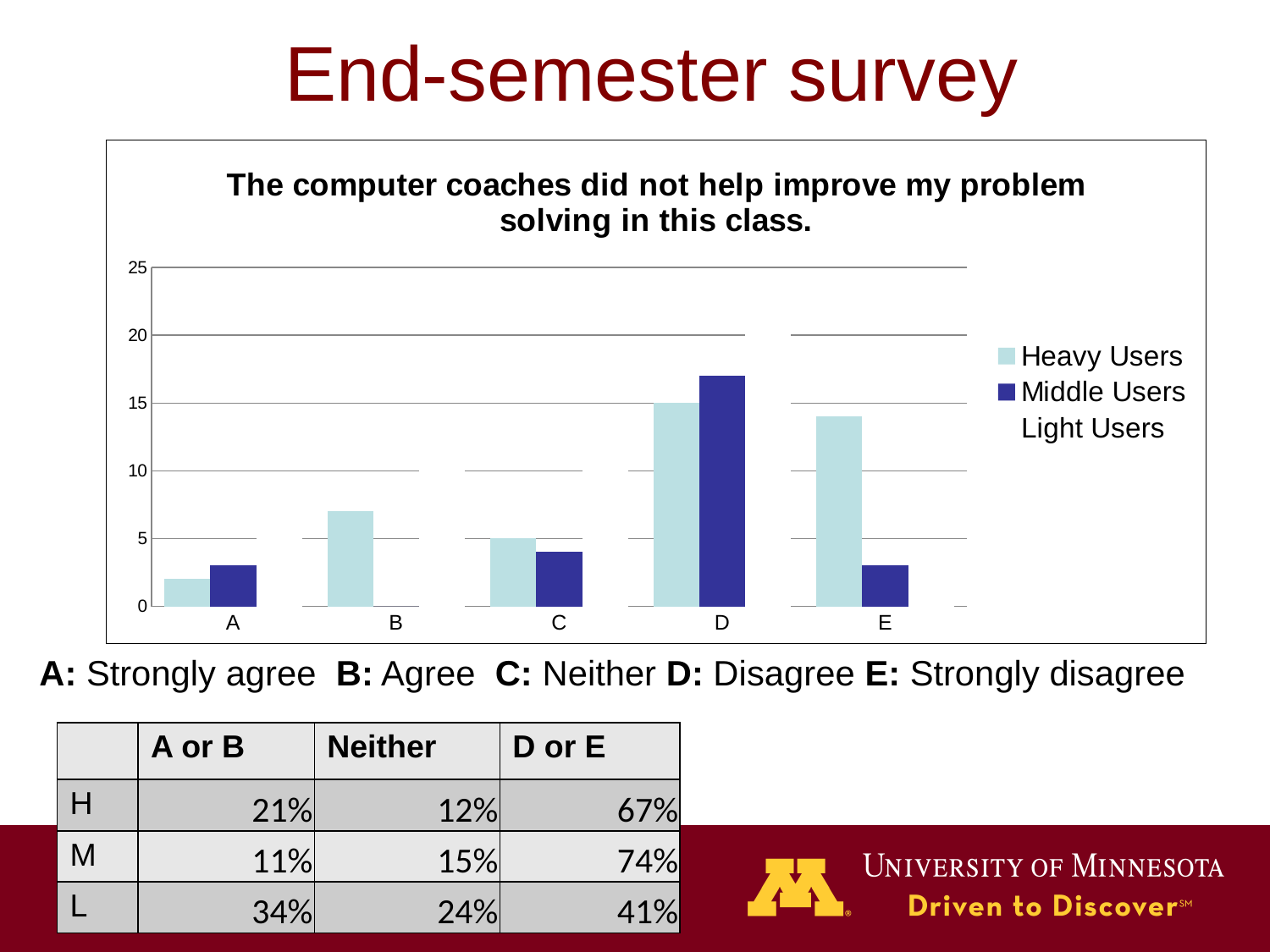
What kind of chart is shown on the slide? bar chart Which category has the highest Middle Users bar? D Is the Middle Users value for E greater or less than 5? less How many series does the chart legend list? 3 How many categories are shown on the x axis of the chart? 5 Is the Middle Users value for D greater or less than 15? greater Which category has the lowest Heavy Users bar? A For category D, which series has the larger bar, Heavy Users or Middle Users? Middle Users For category E, which series has the larger bar, Heavy Users or Middle Users? Heavy Users Is the Heavy Users value for D greater or less than 10? greater What is the title of the chart? The computer coaches did not help improve my problem solving in this class.